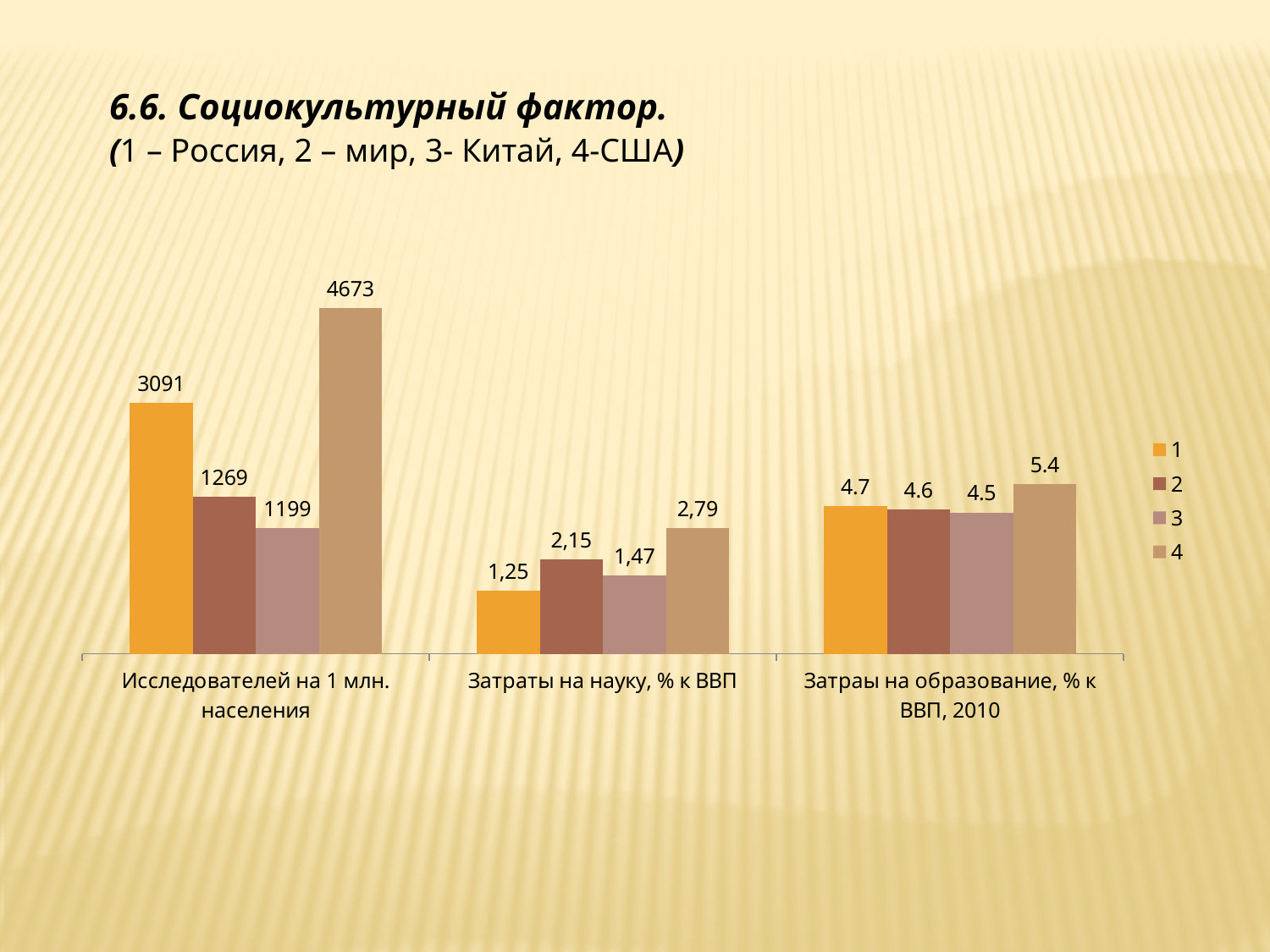
What is the difference between series 4 and series 1 in the category "Исследователей на 1 млн. населения"? 1582 Which series has the lowest value in the category "Затраты на науку, % к ВВП"? 1 Which series is shown in orange in the legend? 1 Which series has the highest value in the category "Исследователей на 1 млн. населения"? 4 What is the value for series 1 in the category "Затраты на науку, % к ВВП"? 1,25 What is the difference between series 2 and series 3 in the category "Затраты на науку, % к ВВП"? 0,68 What is the value for series 3 in the category "Затраы на образование, % к ВВП, 2010"? 4.5 How many categories are shown on the x axis? 3 How many series does the legend list? 4 What is the value for series 4 in the category "Исследователей на 1 млн. населения"? 4673 In the category "Затраы на образование, % к ВВП, 2010", which is larger: series 4 or series 1? 4 What kind of chart is shown on the slide? bar chart